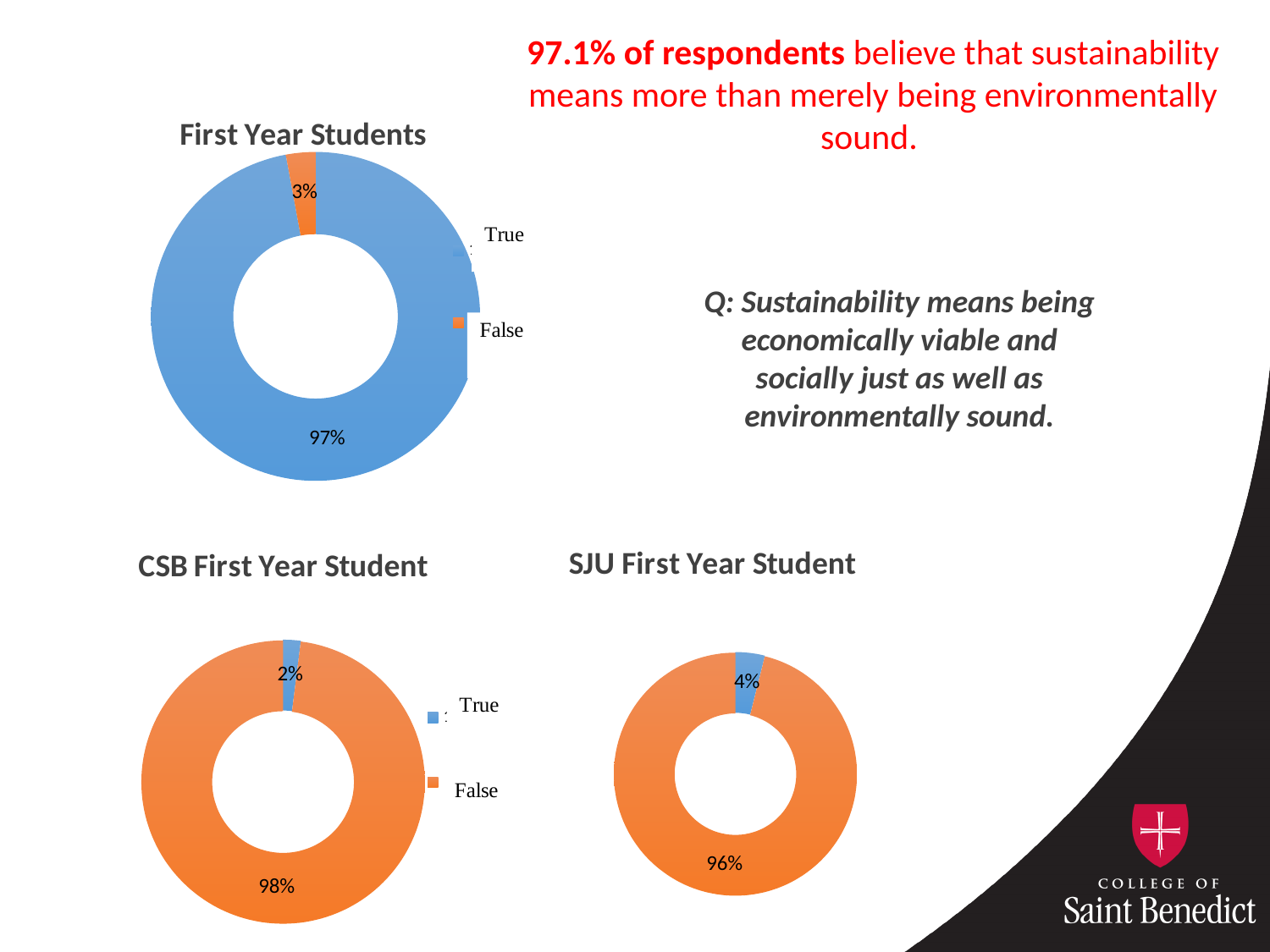
In the 'First Year Students' chart, what percentage is shown for False? 3% In the 'First Year Students' chart, what is the difference in percentage points between True and False? 94 How many entries does the legend of the 'First Year Students' chart list? 2 In the 'CSB First Year Student' chart, what percentage is shown on the blue slice? 2% In the 'SJU First Year Student' chart, what is the smallest percentage shown? 4% How many slices does the 'CSB First Year Student' chart have? 2 In the 'CSB First Year Student' chart, what percentage is shown on the orange slice? 98% In the 'First Year Students' chart, which category has the largest share? True What kind of chart is the 'First Year Students' chart? Donut (pie) chart In the 'First Year Students' chart, what percentage is shown for True? 97% In the 'SJU First Year Student' chart, what is the largest percentage shown? 96% Which is larger: the blue slice in the 'CSB First Year Student' chart or the blue slice in the 'SJU First Year Student' chart? SJU First Year Student